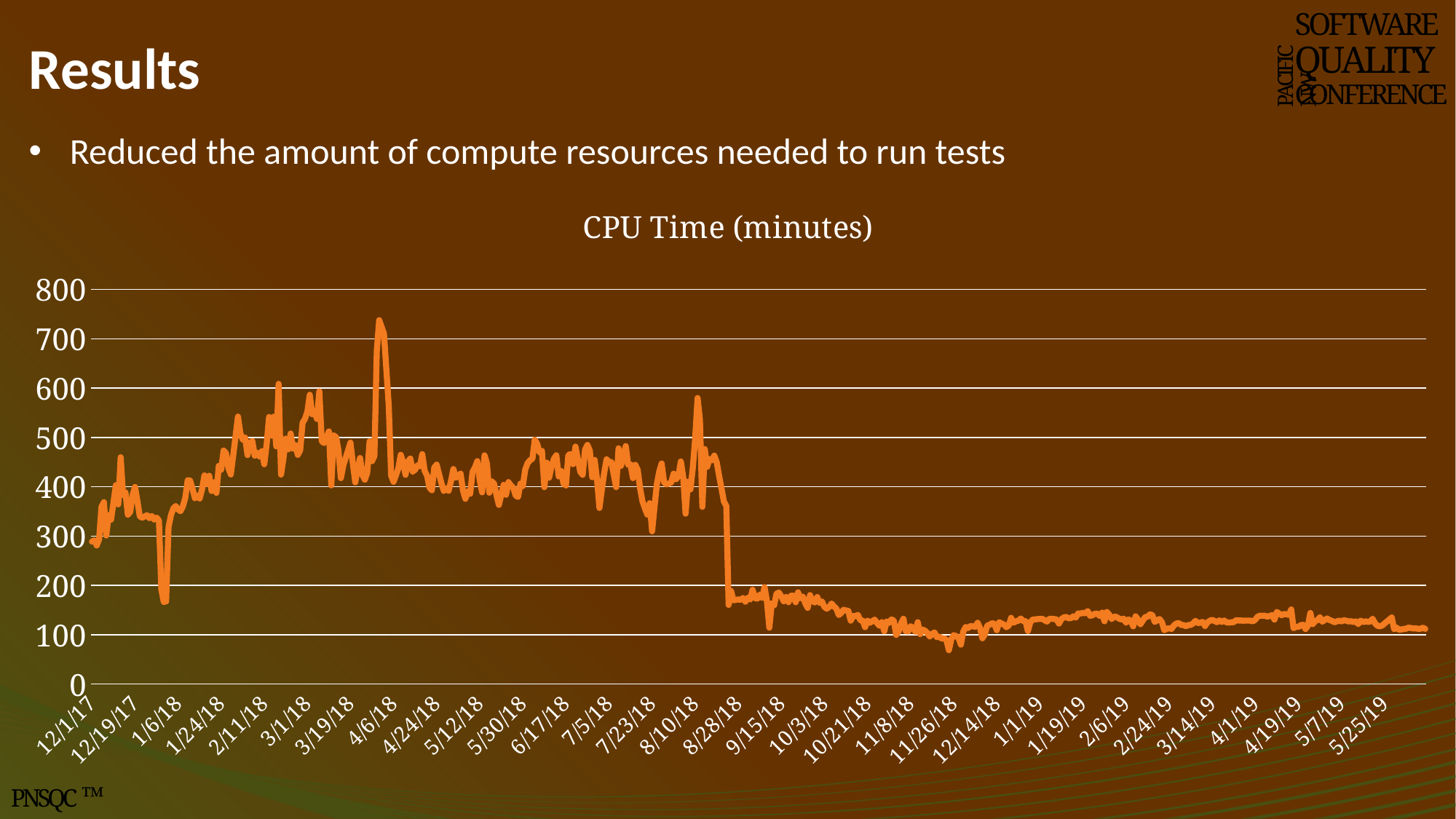
Is the CPU time value at 5/25/19 greater or less than 200? less Near which x-axis date label does the line reach its highest value? 4/6/18 Near which x-axis date label does the line reach its lowest value? 11/26/18 Is the CPU time value at 9/15/18 greater or less than 300? less Is the peak CPU time value near 4/6/18 greater or less than 700? greater What is the title of the chart? CPU Time (minutes) What kind of chart is shown on the slide? line chart Overall, do the CPU time values rise or fall from the left of the x axis to the right? fall What is the highest value shown on the y axis? 800 Which is larger, the CPU time near 4/6/18 or the CPU time near 5/25/19? 4/6/18